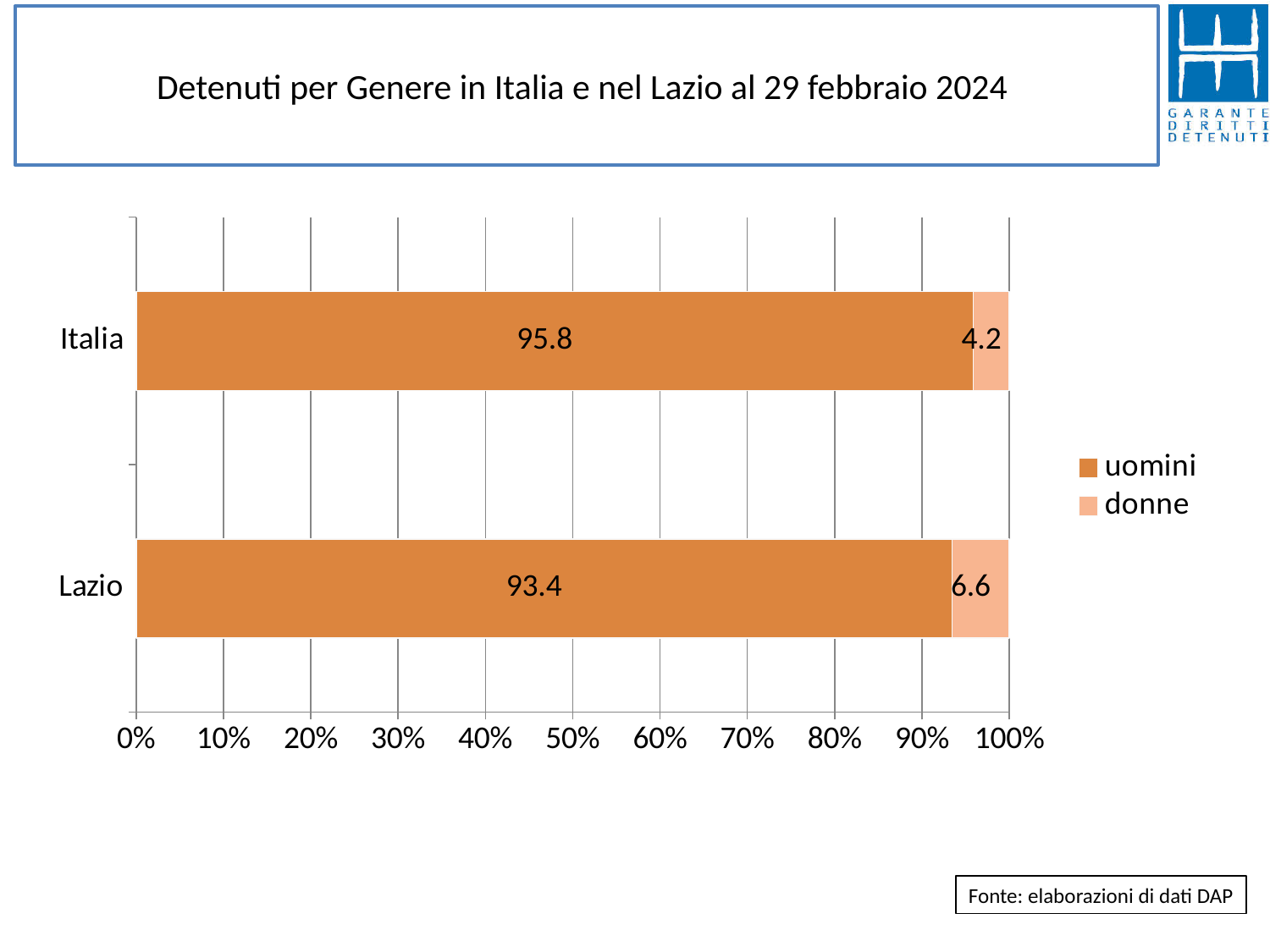
Which category has the highest value for uomini? Italia What is the difference between the uomini values for Italia and Lazio? 2.4 What kind of chart is shown on the slide? bar chart How many categories are shown on the chart? 2 Which category has the higher value for donne, Italia or Lazio? Lazio What is the value for donne in Lazio? 6.6 What is the value for donne in Italia? 4.2 What is the value for uomini in Italia? 95.8 Is the value for uomini in Lazio greater or less than 90%? greater What is the value for uomini in Lazio? 93.4 What is the difference between the donne values for Lazio and Italia? 2.4 How many series does the legend list? 2